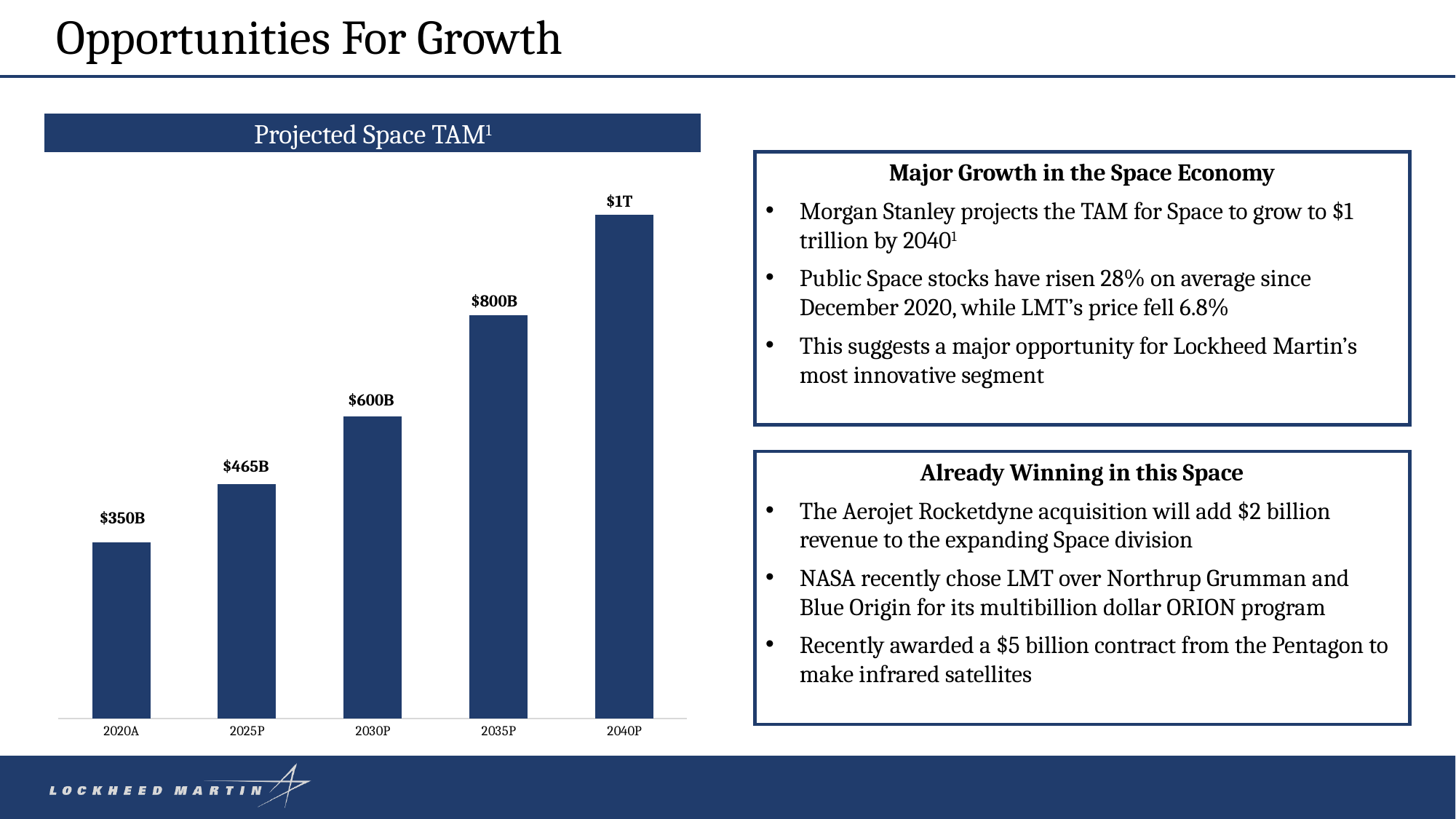
How many years are shown on the Projected Space TAM chart? 5 What is the projected Space TAM for 2040P? $1T What is the projected Space TAM for 2025P? $465B What is the difference between the Space TAM for 2025P and 2020A? $115B Which year has the highest projected Space TAM? 2040P What is the difference between the Space TAM for 2035P and 2030P? $200B What is the Space TAM value shown for 2020A? $350B Which is larger, the Space TAM for 2035P or for 2025P? 2035P What is the projected Space TAM for 2030P? $600B What kind of chart is the Projected Space TAM chart? Bar chart Which year has the lowest Space TAM value? 2020A Do the Space TAM values rise or fall from 2020A to 2040P? Rise